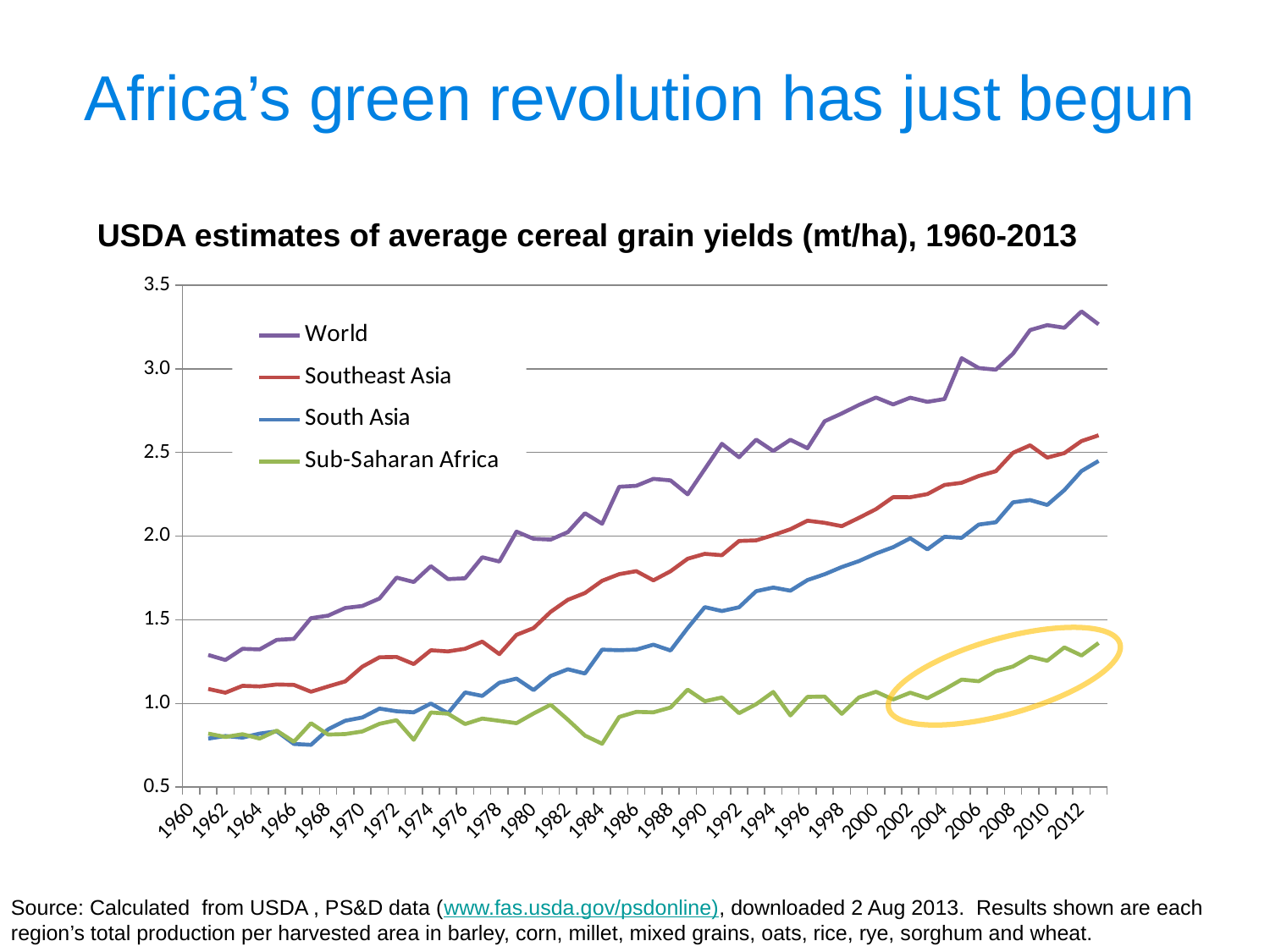
Which series is highlighted by the yellow oval on the chart? Sub-Saharan Africa Is the South Asia yield in 2012 greater or less than 2.0? greater Does the World yield generally rise or fall from 1960 to 2012? rise In 2012, which is larger: the yield for Southeast Asia or for South Asia? Southeast Asia Which series has the lowest yield in 2012? Sub-Saharan Africa How many series does the chart's legend list? 4 What is the title of the chart? USDA estimates of average cereal grain yields (mt/ha), 1960-2013 Is the Sub-Saharan Africa yield in 1984 greater or less than 1.0? less Which series has the highest yield in 2012? World Is the Sub-Saharan Africa yield in 2012 greater or less than 1.5? less What kind of chart is shown on the slide? Line chart